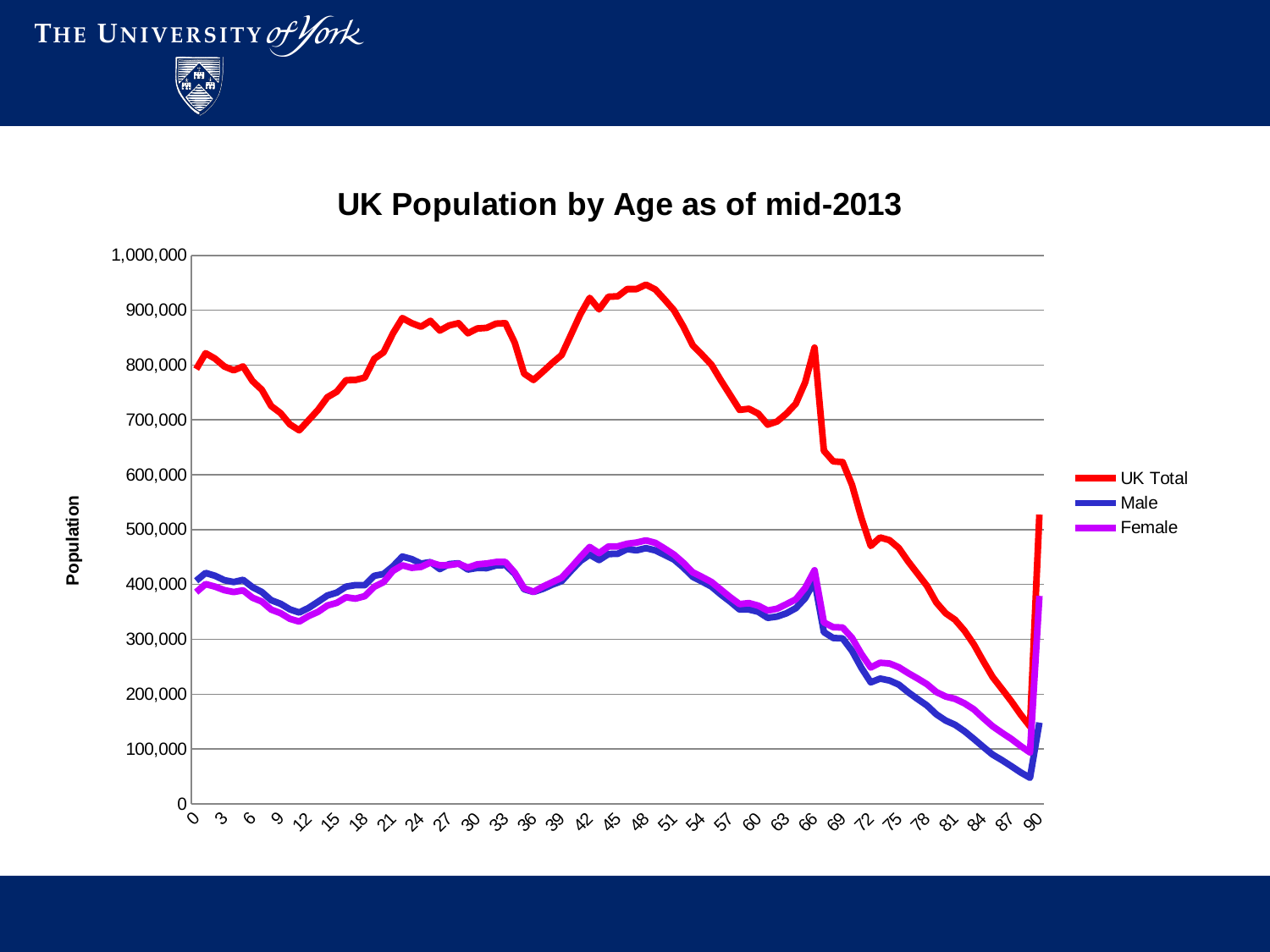
Is the Female value at age 90 greater or less than 300,000? greater What is the title of the chart? UK Population by Age as of mid-2013 At age 87, which series has the larger value, Male or Female? Female Is the UK Total value at age 36 greater or less than 700,000? greater At age 3, which series has the larger value, Male or Female? Male How many series does the legend list? 3 Is the Male value at age 87 greater or less than 100,000? less What kind of chart is shown on the slide? line chart What are the series names listed in the legend? UK Total, Male, Female Does the UK Total line rise or fall between age 66 and age 87? fall